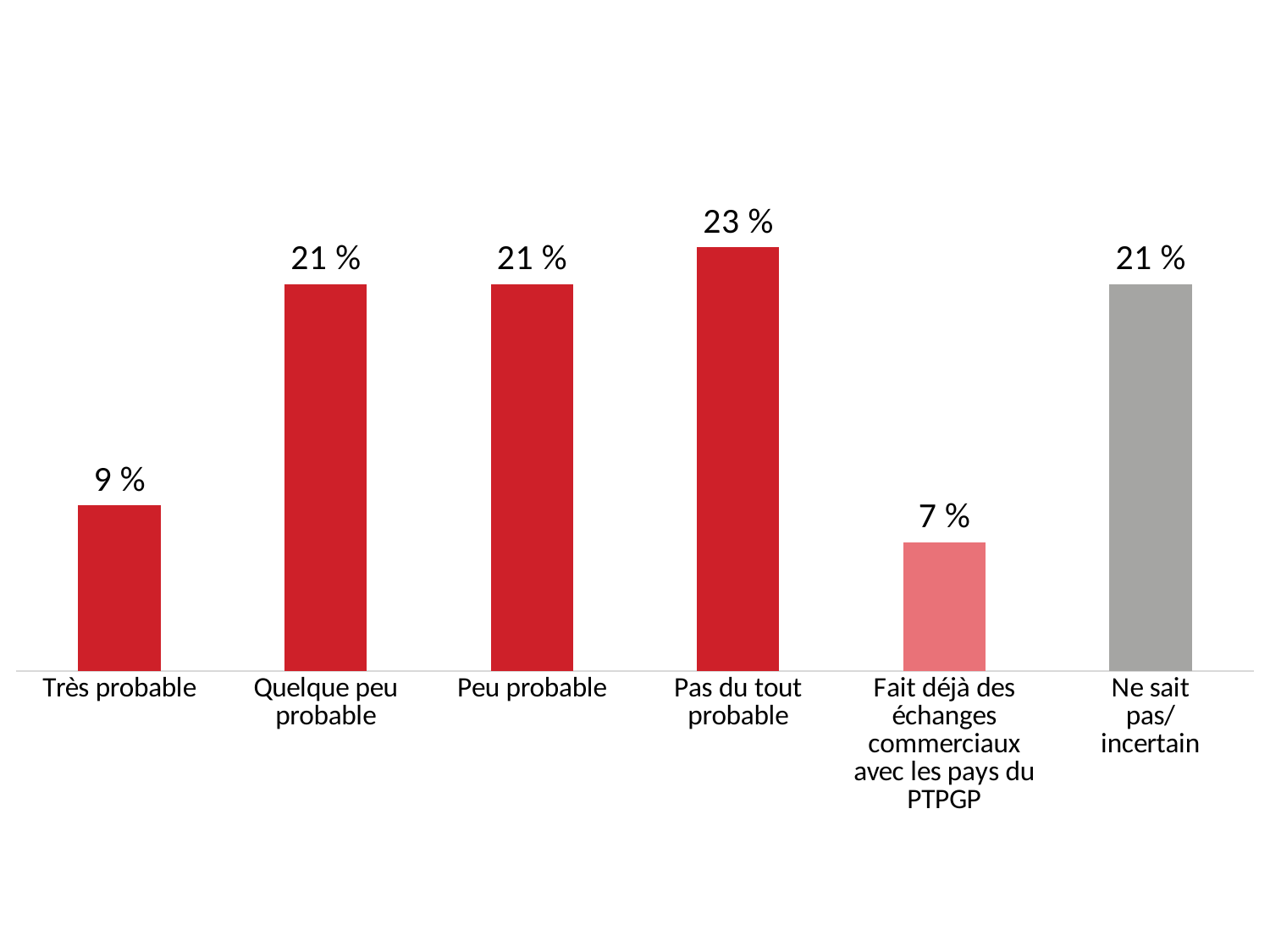
Which category has the lowest value? Fait déjà des échanges commerciaux avec les pays du PTPGP What is the difference between the values for "Pas du tout probable" and "Très probable"? 14 % What is the value for "Très probable"? 9 % What is the value for "Fait déjà des échanges commerciaux avec les pays du PTPGP"? 7 % Which category has the highest value? Pas du tout probable How many categories are shown in the chart? 6 What is the difference between the values for "Très probable" and "Fait déjà des échanges commerciaux avec les pays du PTPGP"? 2 % What is the value for "Ne sait pas/ incertain"? 21 % What is the value for "Pas du tout probable"? 23 % Which bar is coloured grey? Ne sait pas/ incertain Which is larger, the value for "Très probable" or the value for "Quelque peu probable"? Quelque peu probable What kind of chart is shown on the slide? Bar chart